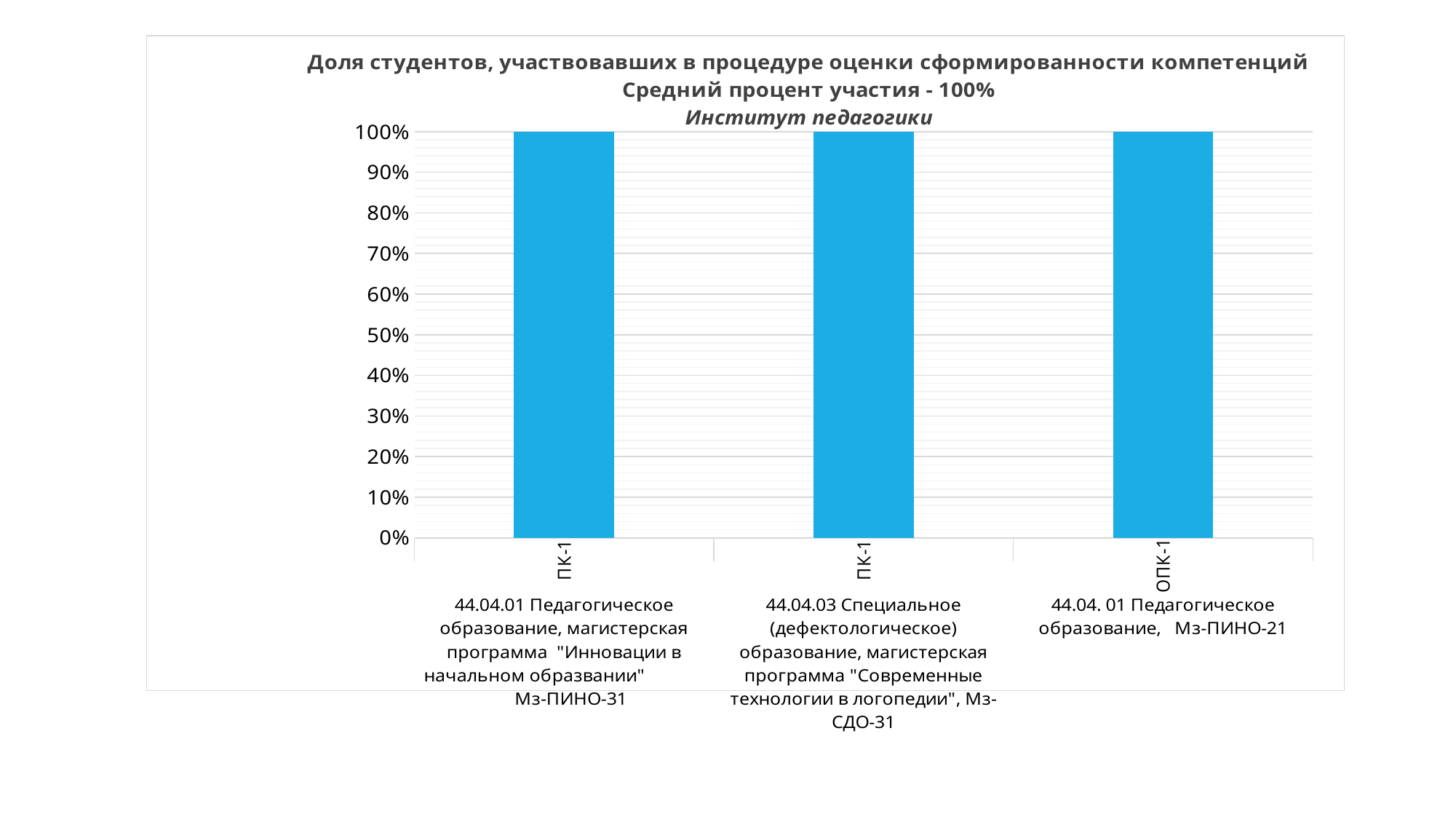
How many bars are plotted in the chart? 3 What kind of chart is shown on the slide? bar chart Is the value for ПК-1 (Мз-СДО-31) greater or less than 90%? greater What is the value for ОПК-1 in the group 44.04.01 Педагогическое образование, Мз-ПИНО-21? 100% What is the highest value shown on the vertical axis? 100% What is the value for ПК-1 in the group 44.04.01 Педагогическое образование, магистерская программа "Инновации в начальном образовании" Мз-ПИНО-31? 100% Is the value for ОПК-1 (Мз-ПИНО-21) greater or less than 50%? greater Do the values rise, fall, or stay the same across the bars from left to right? stay the same What is the value for ПК-1 in the group 44.04.03 Специальное (дефектологическое) образование, Мз-СДО-31? 100% Which institute is named in the chart title? Институт педагогики What is the difference between the value for ПК-1 (Мз-ПИНО-31) and the value for ОПК-1 (Мз-ПИНО-21)? 0%